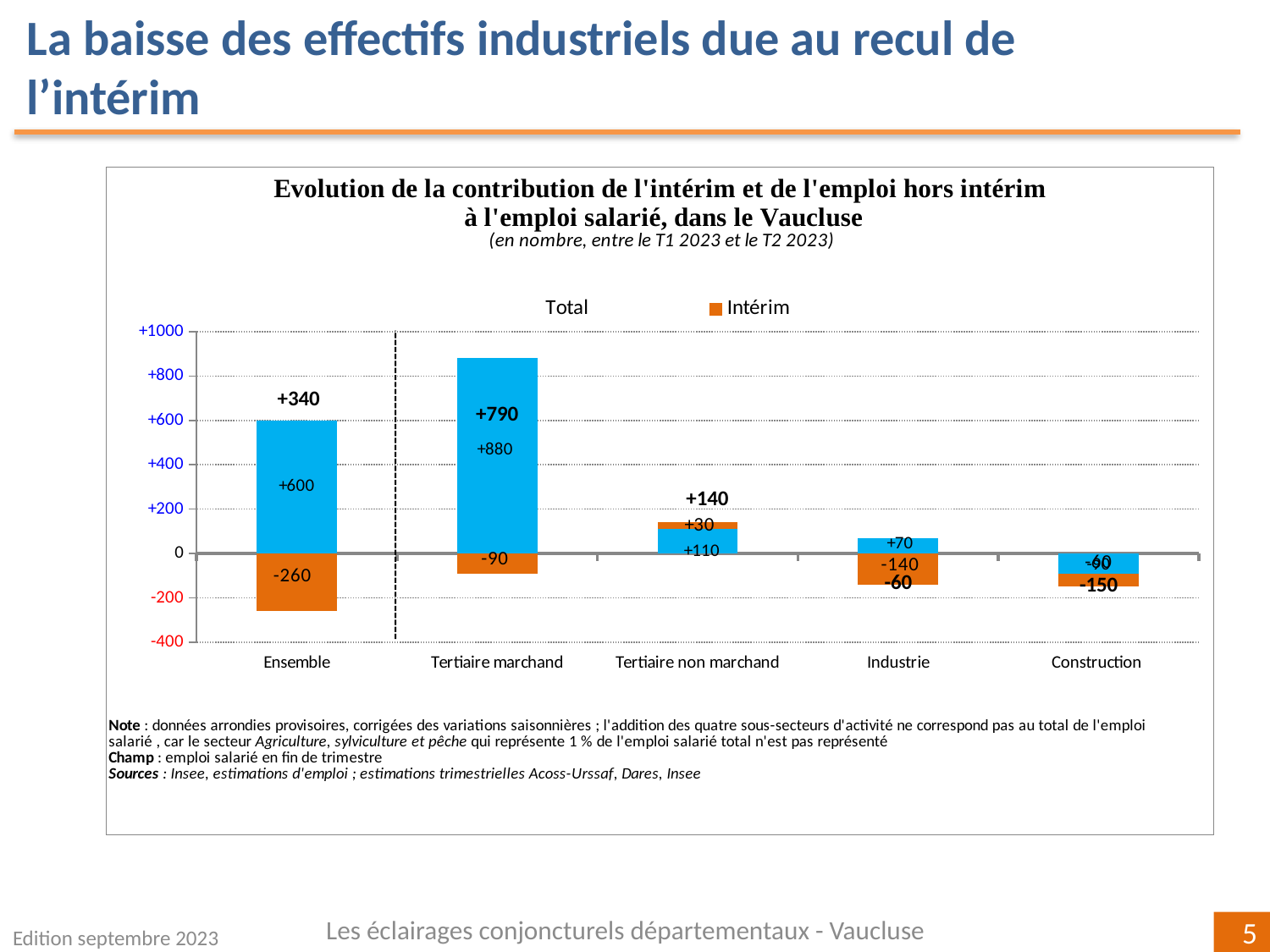
Which category has the highest total value? Tertiaire marchand What is the Intérim value shown for Industrie? -140 How many series does the legend list? 2 Which category has the lowest total value? Construction What is the total value shown for Ensemble? +340 What kind of chart is shown on the slide? Bar chart What is the difference between the total for Tertiaire marchand and the total for Ensemble? 450 How many categories are shown on the x axis? 5 What is the Intérim value shown for Ensemble? -260 What is the total value shown for Construction? -150 What is the total value shown for Tertiaire marchand? +790 What is the value of the blue bar for Tertiaire marchand? +880